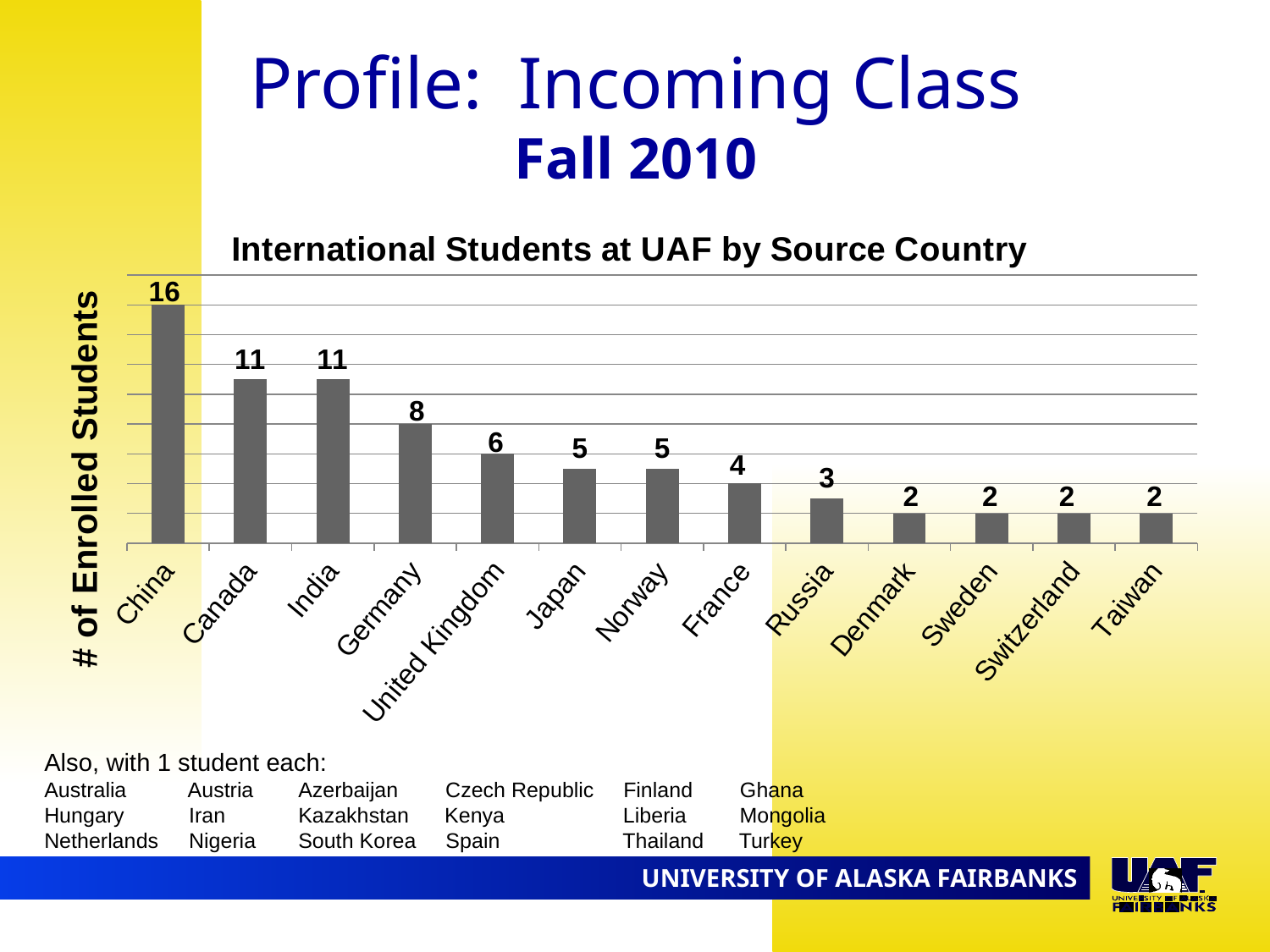
How many enrolled students are from China? 16 What is the difference between the number of students from Germany and from France? 4 What is the difference between the number of students from China and from Canada? 5 Which country has the highest number of enrolled students? China Which has more enrolled students, Japan or Russia? Japan How many enrolled students are from Germany? 8 What is the title of the chart? International Students at UAF by Source Country What type of chart is shown on the slide? Bar chart Do the values rise or fall moving from left to right along the x axis? Fall How many enrolled students are from the United Kingdom? 6 How many countries are shown as bars in the chart? 13 Which has more enrolled students, India or Germany? India